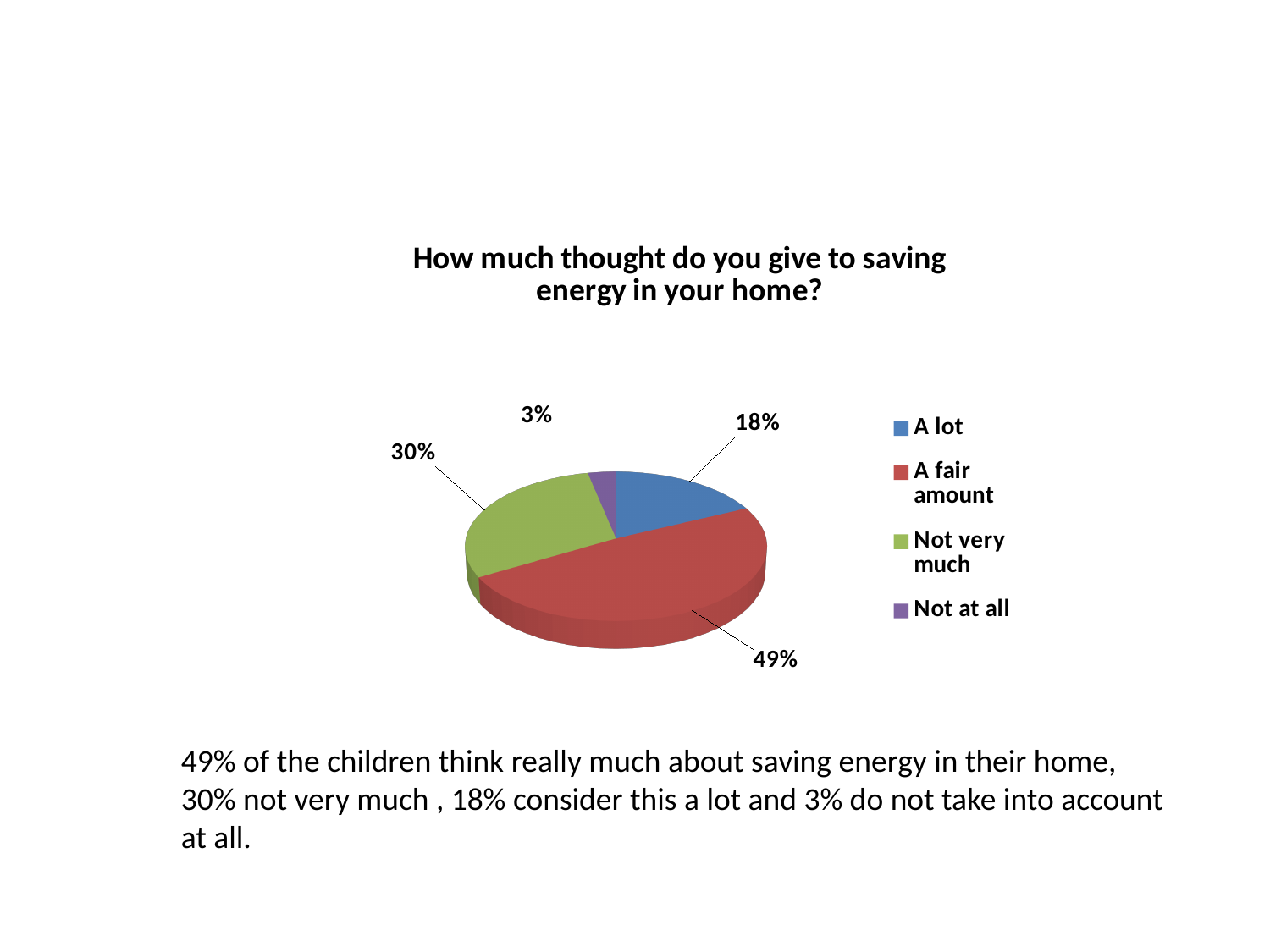
What is the title of the chart? How much thought do you give to saving energy in your home? What percentage of respondents answered "A fair amount"? 49% Which colour represents "Not very much" in the legend? Green Which response has the smallest share of the pie? Not at all What is the difference in percentage points between "A fair amount" and "Not very much"? 19 What kind of chart is shown on the slide? Pie chart How many categories does the pie chart show? 4 What percentage of respondents answered "Not at all"? 3% What percentage of respondents answered "A lot"? 18% Which response has the largest share of the pie? A fair amount What percentage of respondents answered "Not very much"? 30% Which is larger, the share for "A lot" or the share for "Not very much"? Not very much